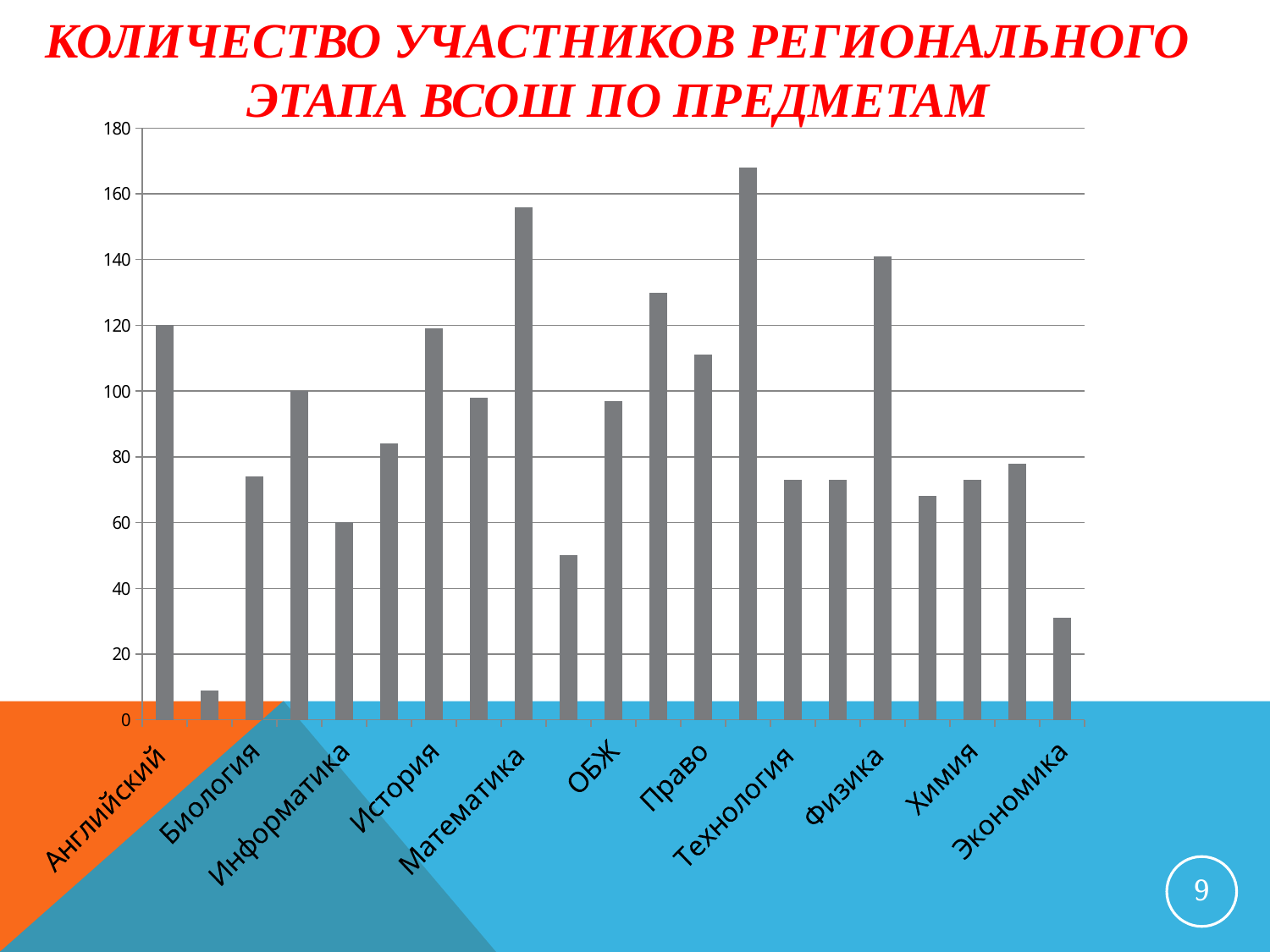
What is the value for Английский? 120 Is the value for Информатика greater or less than 80? less Is the value for Экономика greater or less than 40? less Which has a larger value, Физика or Химия? Физика Is the value for Право greater or less than 100? greater What is the title of the chart? КОЛИЧЕСТВО УЧАСТНИКОВ РЕГИОНАЛЬНОГО ЭТАПА ВСОШ ПО ПРЕДМЕТАМ Which has a larger value, Математика or Экономика? Математика What colour are the bars in the chart? grey What kind of chart is shown on the slide? bar chart How many bars are plotted in the chart? 21